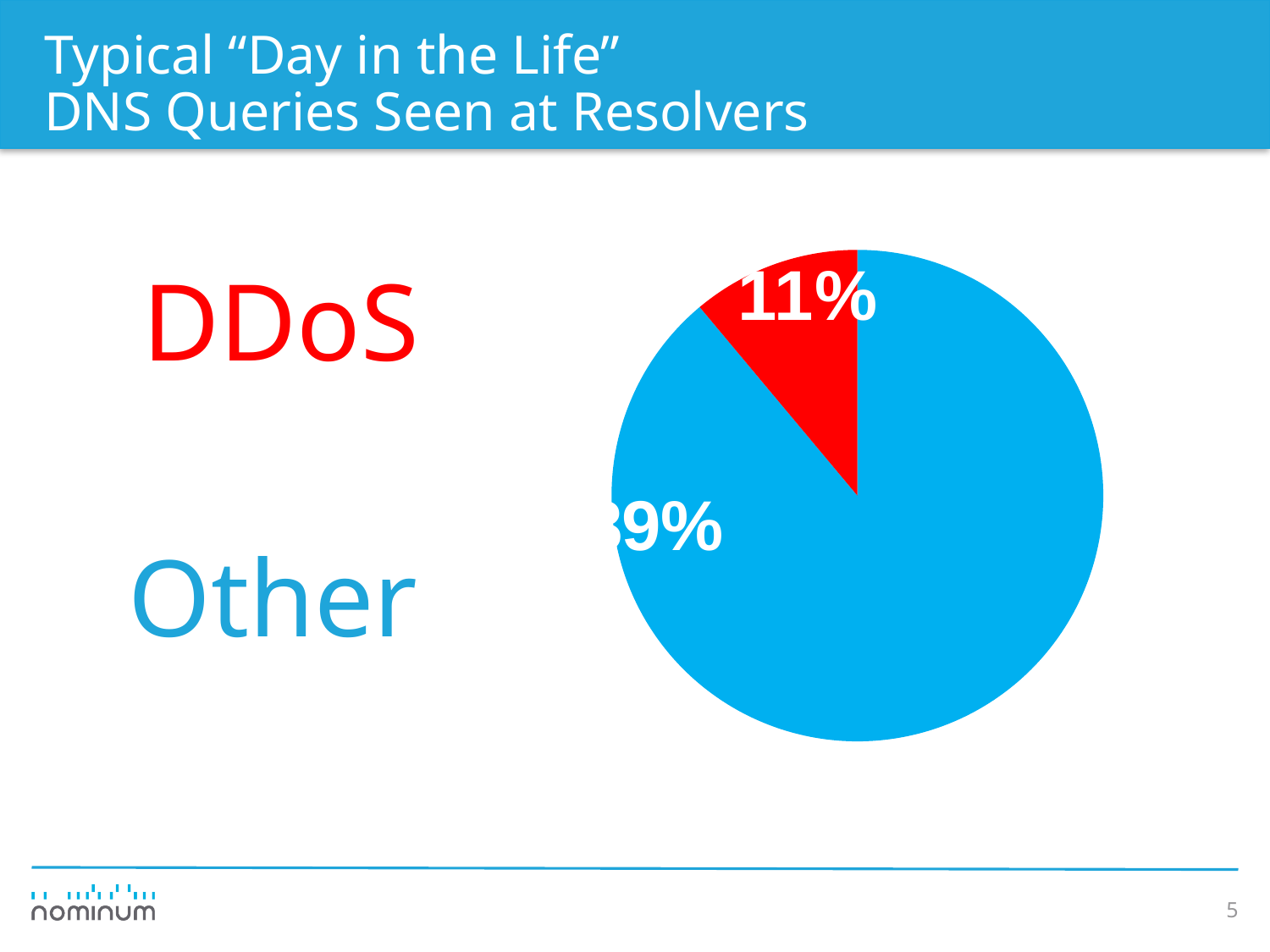
What is the title of the slide containing the pie chart? Typical "Day in the Life" DNS Queries Seen at Resolvers What share of DNS queries does the DDoS slice represent? 11% Which category has the largest share of the pie? Other Which category has the smallest share of the pie? DDoS What kind of chart is shown on the slide? pie chart How many slices does the pie chart have? 2 Which slice is larger, DDoS or Other? Other What colour is the DDoS slice of the pie chart? red